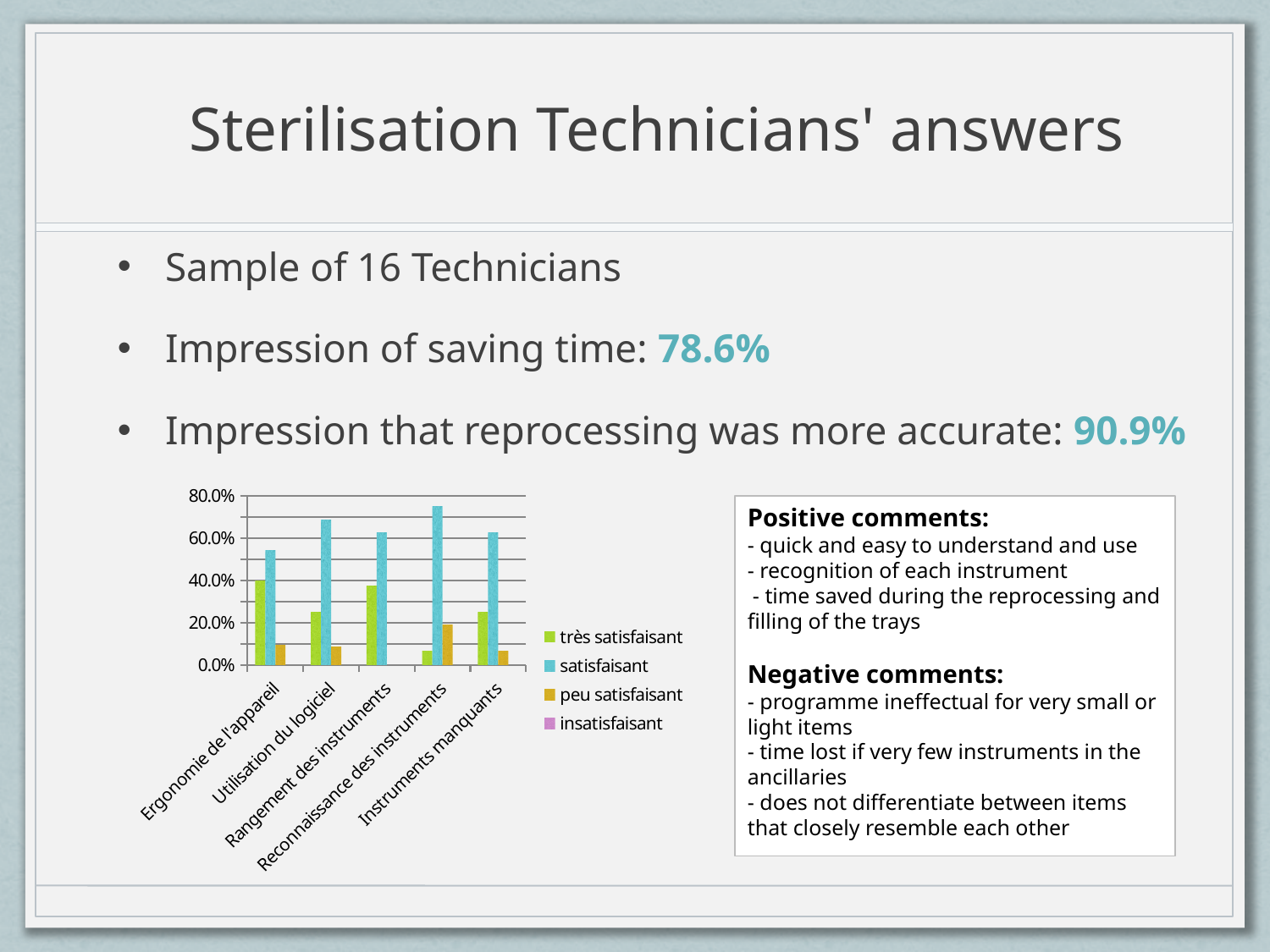
Is the 'satisfaisant' value for Utilisation du logiciel greater or less than 60.0%? greater Which category has the lowest 'très satisfaisant' bar? Reconnaissance des instruments Is the 'très satisfaisant' value for Reconnaissance des instruments greater or less than 20.0%? less Which category has the highest 'peu satisfaisant' bar? Reconnaissance des instruments How many series does the chart's legend list? 4 Which category has the highest 'satisfaisant' bar? Reconnaissance des instruments How many categories are shown on the x axis of the chart? 5 Which legend entry is shown in green? très satisfaisant For Instruments manquants, which is larger: the 'très satisfaisant' value or the 'peu satisfaisant' value? très satisfaisant For Ergonomie de l'appareil, which is larger: the 'satisfaisant' value or the 'très satisfaisant' value? satisfaisant What kind of chart is shown on the slide? bar chart Is the 'satisfaisant' value for Reconnaissance des instruments greater or less than 60.0%? greater